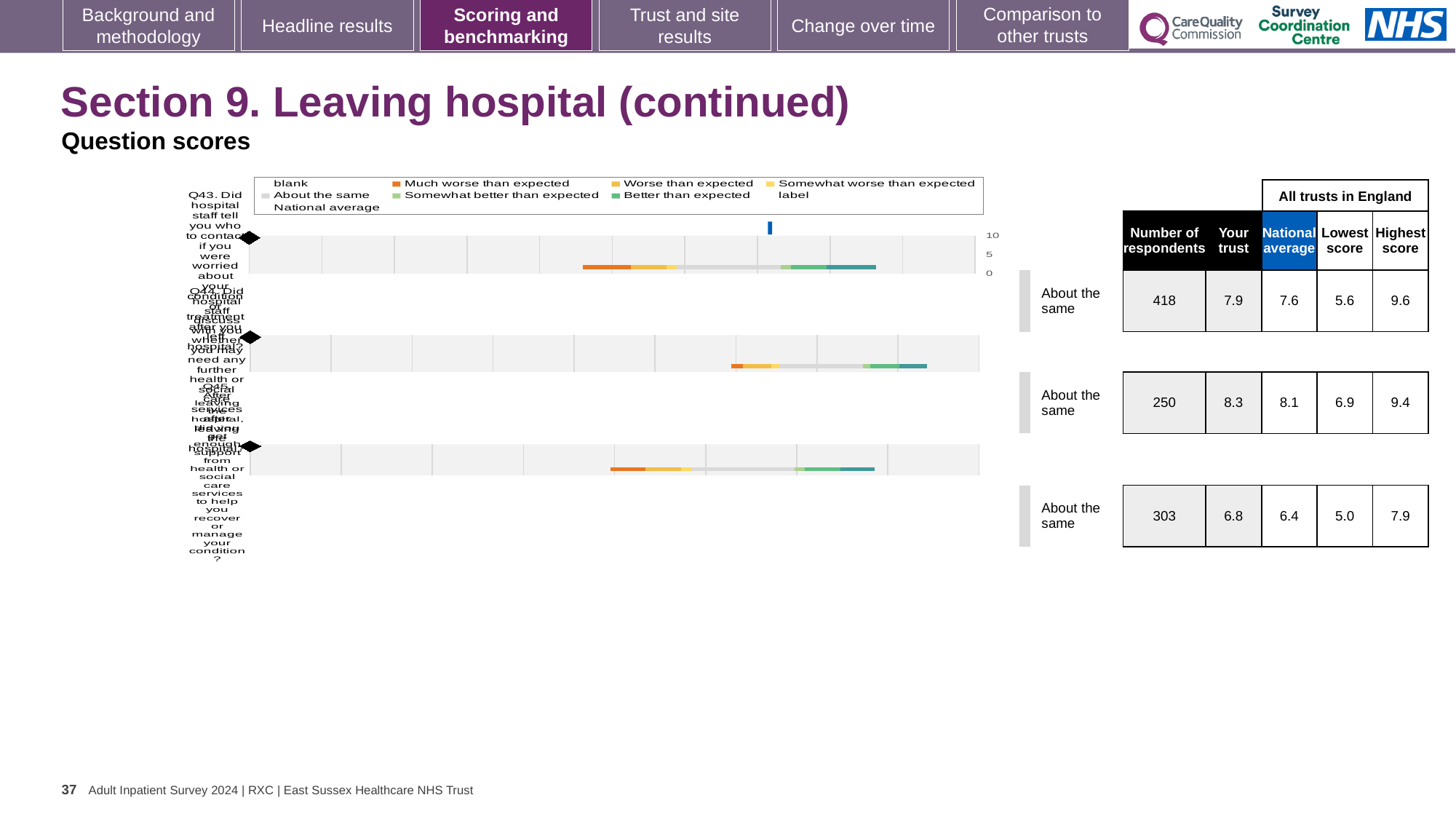
What is the national average score for Q44 (Did hospital staff discuss with you whether you may need any further health or social care services after leaving hospital?)? 8.1 What is the 'Your trust' score for Q43 (Did hospital staff tell you who to contact if you were worried about your condition or treatment after you left hospital?)? 7.9 How many question score charts are shown on the slide? 3 In the chart legend, which entry is shown in dark teal? Better than expected What is the difference between the 'Your trust' score and the national average for Q45? 0.4 What is the highest value shown on the axis of the first chart? 10 Which of the three questions has the highest 'Your trust' score? Q44 Which of the three questions has the lowest 'Your trust' score? Q45 Is the 'Your trust' score for Q43 higher or lower than the national average for Q43? higher What kind of chart is used to show the question scores on this slide? bar chart In the chart legend, which entry is shown in orange? Much worse than expected What is the 'Your trust' score for Q45 (After leaving hospital, did you get enough support from health or social care services to help you recover or manage your condition?)? 6.8